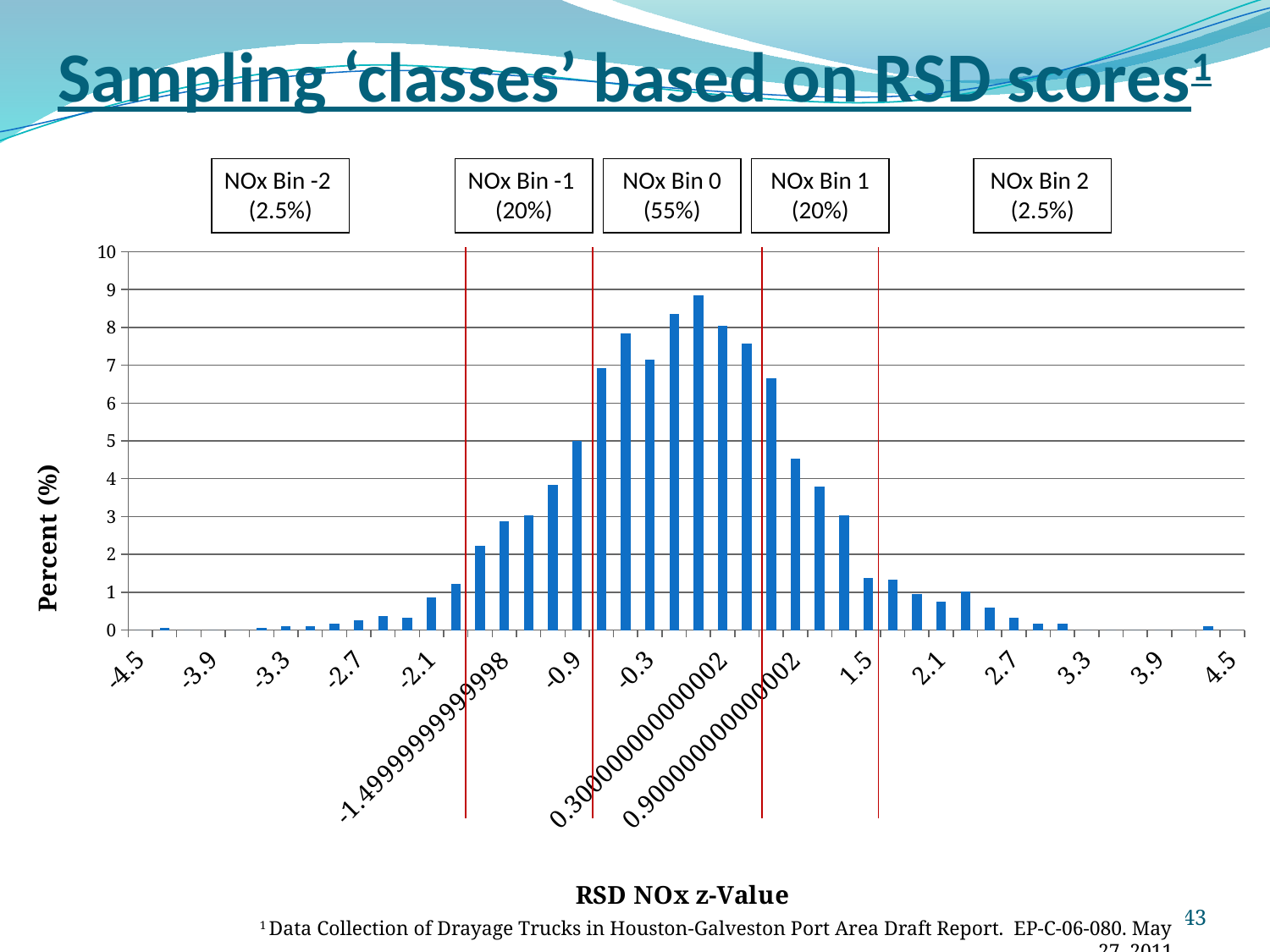
What percentage is shown in the box labelled NOx Bin 0 above the chart? 55% Which bar is taller, the one at -0.9 or the one at 0.9? -0.9 Do the bar values rise or fall along the x axis from -4.5 to -0.9? rise Is the value for the bar at 0.9 greater or less than 6? less Is the value of the tallest bar on the chart greater or less than 8? greater Is the value for the bar at -1.5 greater or less than 2? greater What kind of chart is shown on the slide? bar chart Do the bar values rise or fall along the x axis from 1.5 to 4.5? fall What is the title of the x axis of the chart? RSD NOx z-Value